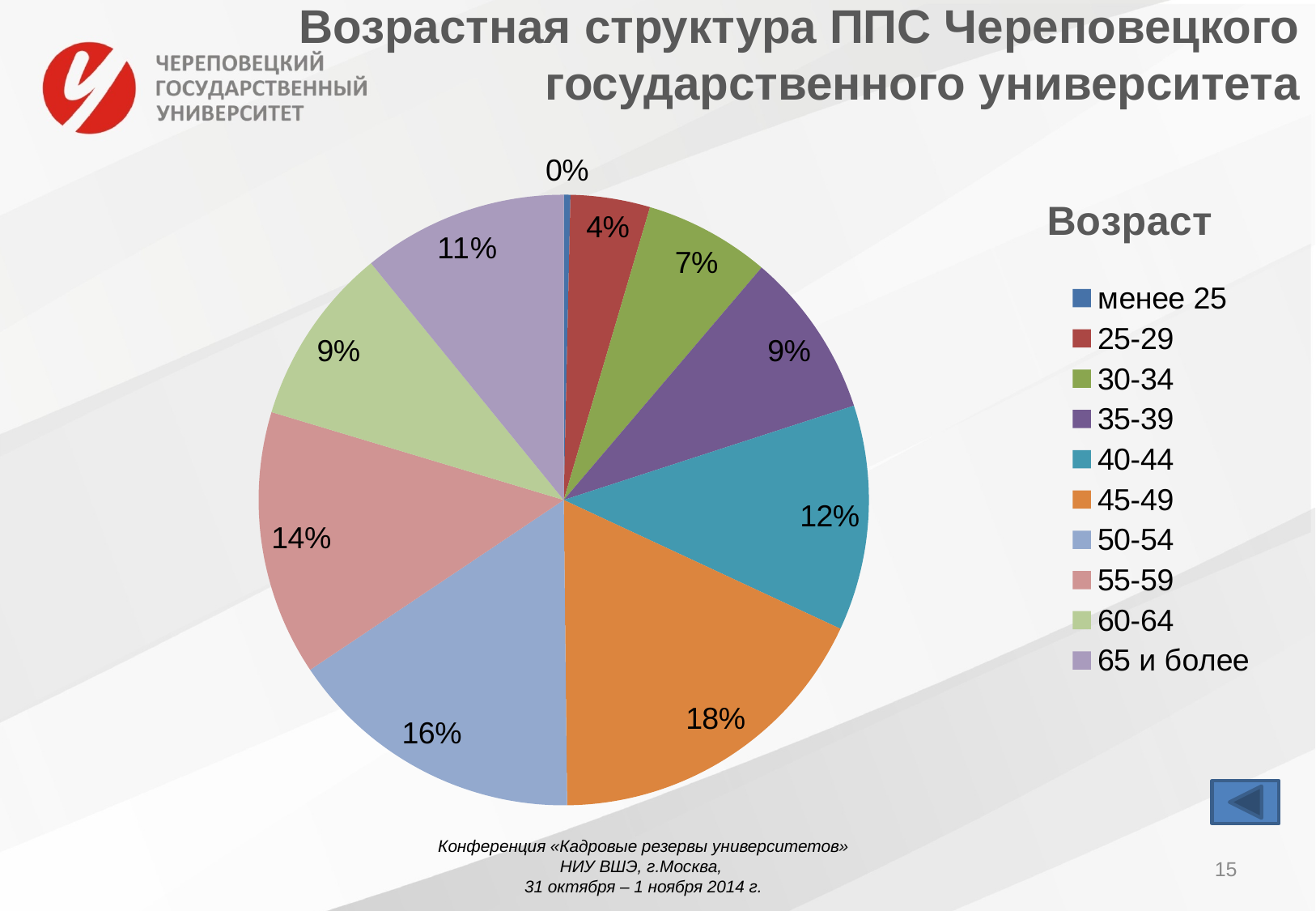
What share of the pie does the 45-49 age group have? 18% Which age group has the smallest share of the pie? менее 25 What kind of chart is shown on the slide? pie chart What is the title of the legend on the slide? Возраст Which age group has the largest share of the pie? 45-49 What share of the pie does the 50-54 age group have? 16% What share of the pie does the 65 и более age group have? 11% What is the difference between the shares of the 45-49 and 40-44 age groups? 6% What share of the pie does the 25-29 age group have? 4% How many age groups does the legend list? 10 Which has a larger share, the 55-59 age group or the 30-34 age group? 55-59 What is the combined share of the 40-44 and 45-49 age groups? 30%